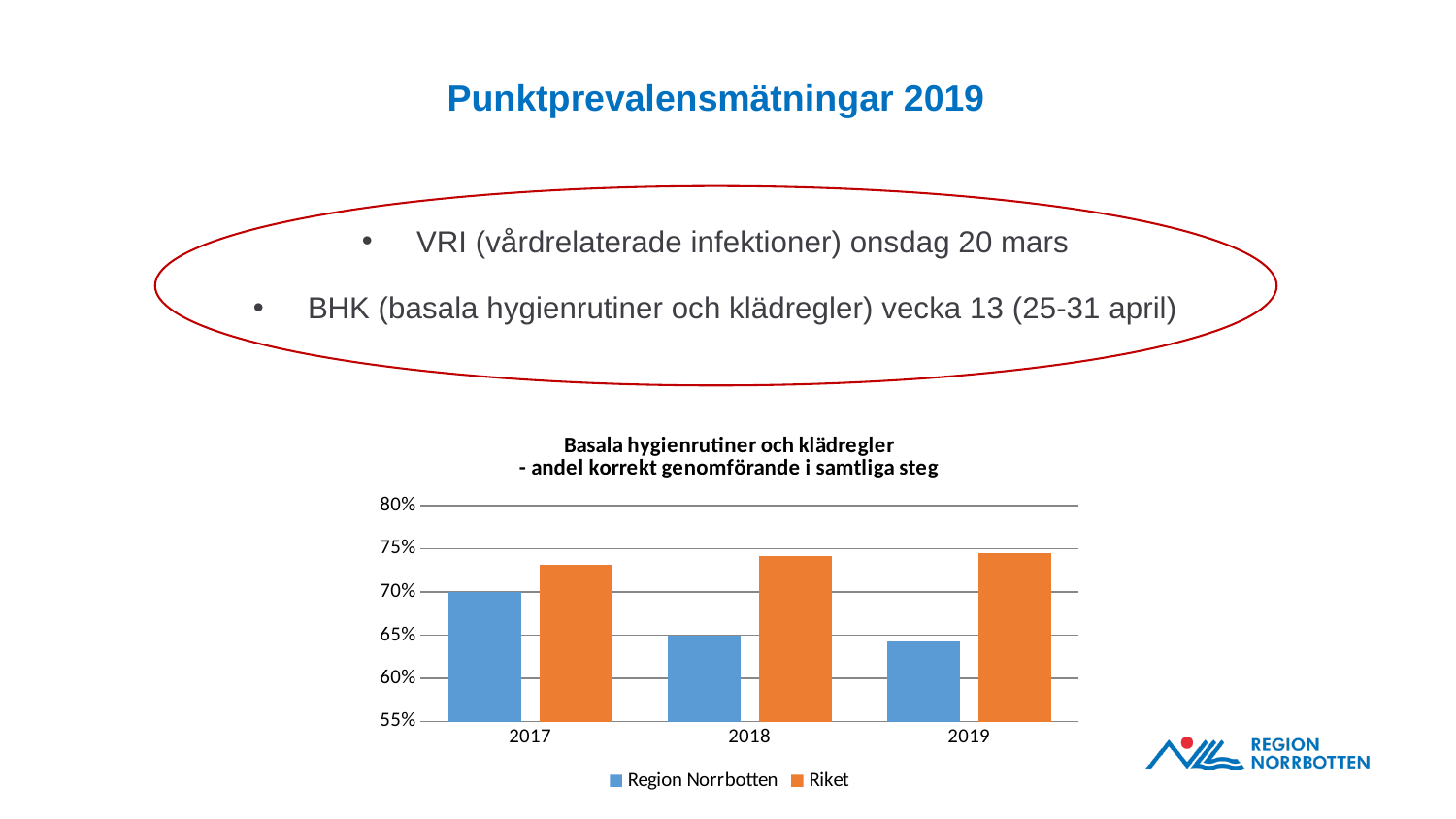
Is the value for Riket in 2017 greater or less than 75%? less In which year is the value for Region Norrbotten highest? 2017 In 2017, which is larger: Region Norrbotten or Riket? Riket How many years are shown on the x axis of the chart? 3 Is the value for Riket in 2018 greater or less than 70%? greater Is the value for Region Norrbotten in 2017 greater or less than 65%? greater How many series does the chart legend list? 2 What kind of chart is shown on the slide? Bar chart Do the values for Region Norrbotten rise or fall from 2017 to 2019? fall Which series are listed in the chart legend? Region Norrbotten and Riket What is the title of the chart? Basala hygienrutiner och klädregler - andel korrekt genomförande i samtliga steg